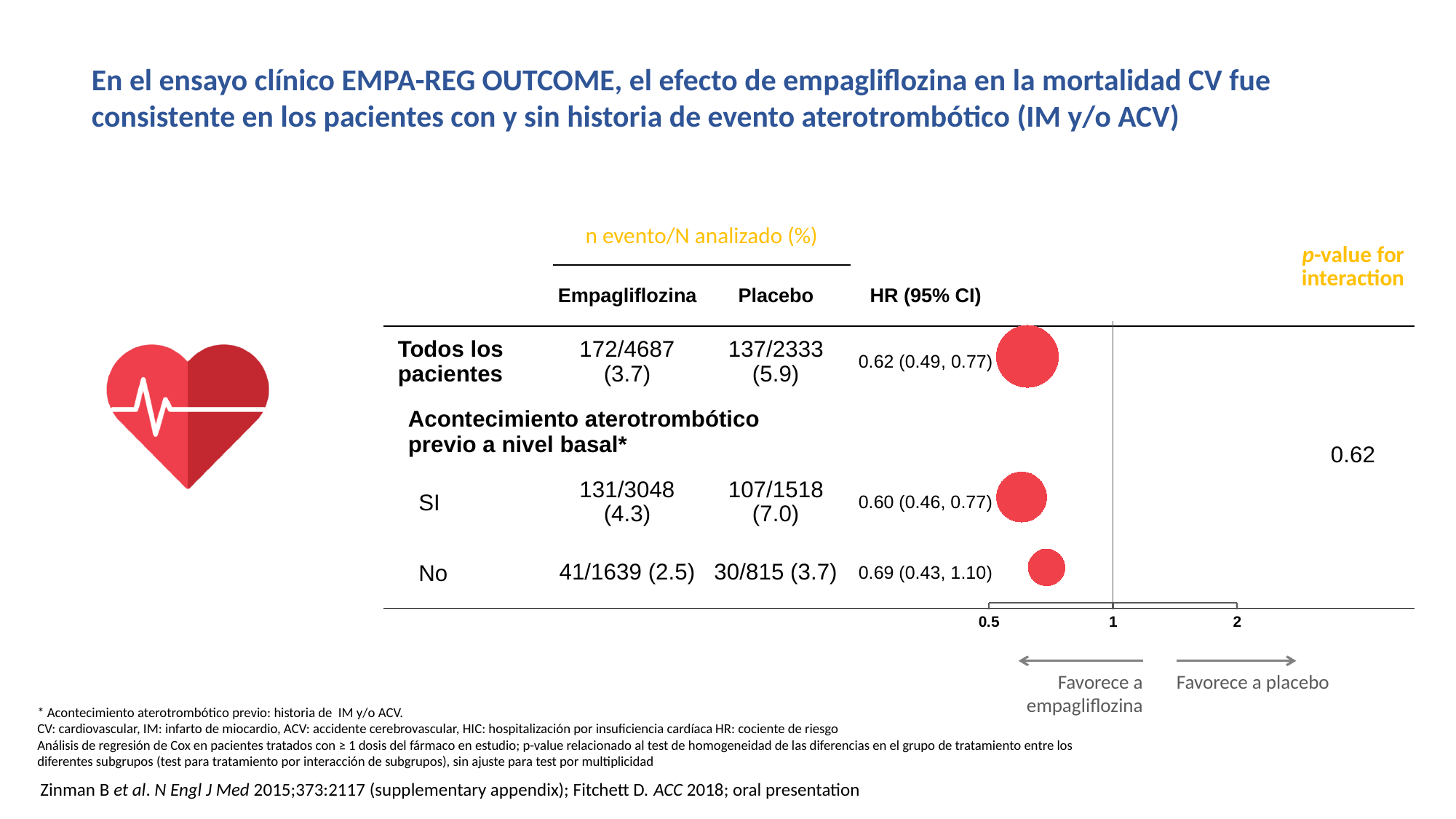
What is the hazard ratio (95% CI) for the 'No' subgroup? 0.69 (0.43, 1.10) What is the n evento/N analizado (%) for Empagliflozina in 'Todos los pacientes'? 172/4687 (3.7) Which subgroup row has the highest hazard ratio point estimate? No What is the n evento/N analizado (%) for Placebo in the 'No' subgroup? 30/815 (3.7) What is the hazard ratio (95% CI) for the 'SI' subgroup (prior atherothrombotic event)? 0.60 (0.46, 0.77) How many hazard ratio points are plotted in the forest plot? 3 What is the difference in event percentage between Placebo (5.9) and Empagliflozina (3.7) for 'Todos los pacientes'? 2.2 What is the p-value for interaction shown on the slide? 0.62 What is the hazard ratio (95% CI) shown for 'Todos los pacientes'? 0.62 (0.49, 0.77) Which subgroup row has the lowest hazard ratio point estimate? SI What does the left arrow below the x axis indicate? Favorece a empagliflozina Is the hazard ratio for the 'No' subgroup greater or less than 1? less